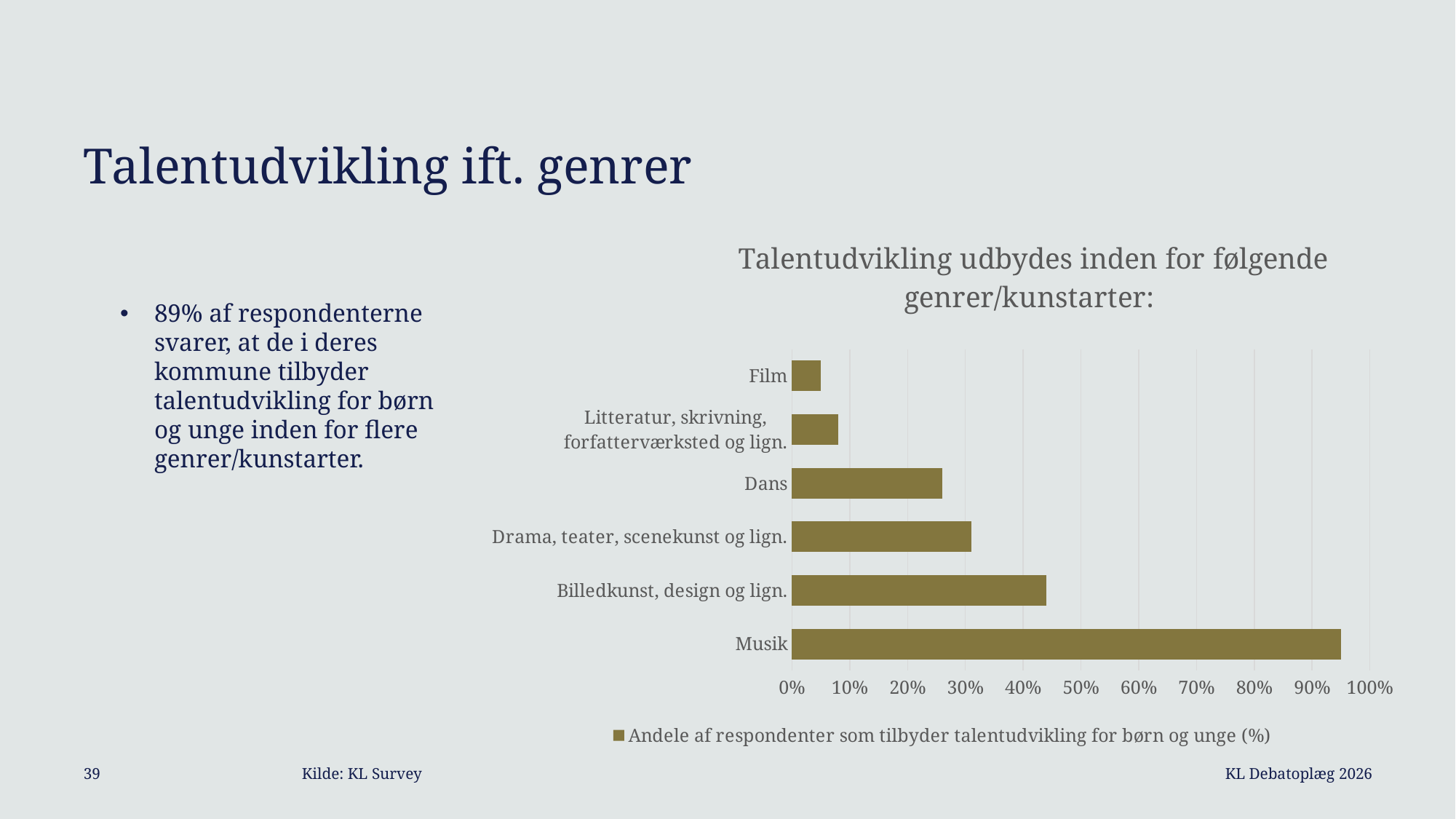
How many series does the legend list? 1 Which is larger, the value for Billedkunst, design og lign. or the value for Dans? Billedkunst, design og lign. Is the value for Film greater or less than 10%? less Is the value for Drama, teater, scenekunst og lign. greater or less than 40%? less Is the value for Dans greater or less than 30%? less How many genres/categories are shown in the chart? 6 What kind of chart is shown on the slide? bar chart What is the title of the chart? Talentudvikling udbydes inden for følgende genrer/kunstarter: Which genre has the lowest share of respondents offering talent development? Film Which genre has the highest share of respondents offering talent development? Musik